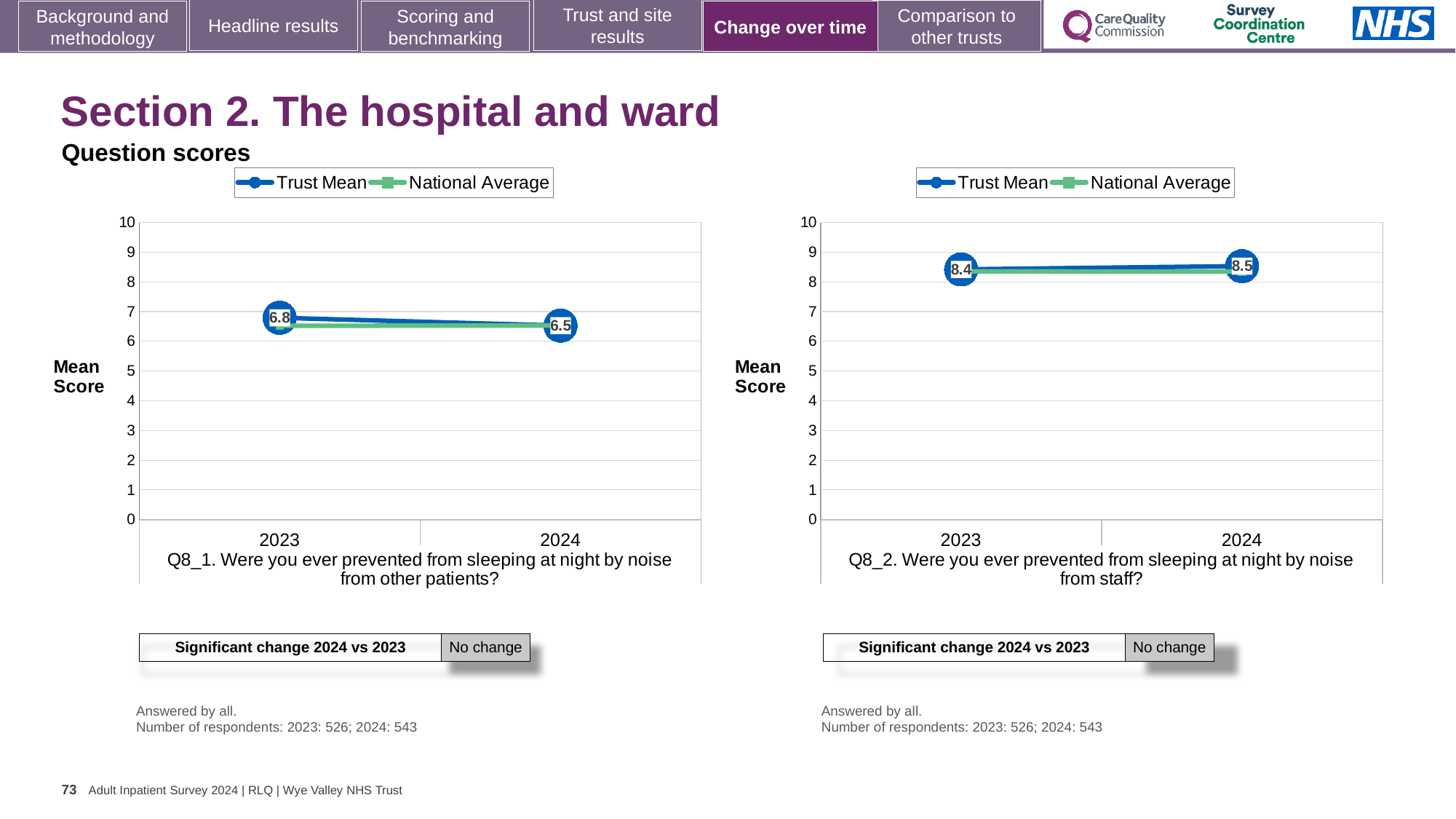
On the left chart (Q8_1), by how much did the Trust Mean change from 2023 to 2024? 0.3 On the right chart (Q8_2), does the Trust Mean rise or fall from 2023 to 2024? rise On the left chart (Q8_1, noise from other patients), what is the Trust Mean score for 2024? 6.5 On the left chart (Q8_1), does the Trust Mean rise or fall from 2023 to 2024? fall On the left chart (Q8_1), is the National Average for 2023 greater or less than 7? less On the left chart (Q8_1, noise from other patients), what is the Trust Mean score for 2023? 6.8 How many series does the legend of the left chart (Q8_1) list? 2 On the right chart (Q8_2), is the National Average for 2024 greater or less than 8? greater On the right chart (Q8_2), what is the difference between the Trust Mean for 2024 and 2023? 0.1 On the right chart (Q8_2, noise from staff), what is the Trust Mean score for 2024? 8.5 What type of chart is the right chart (Q8_2)? line chart On the right chart (Q8_2, noise from staff), what is the Trust Mean score for 2023? 8.4